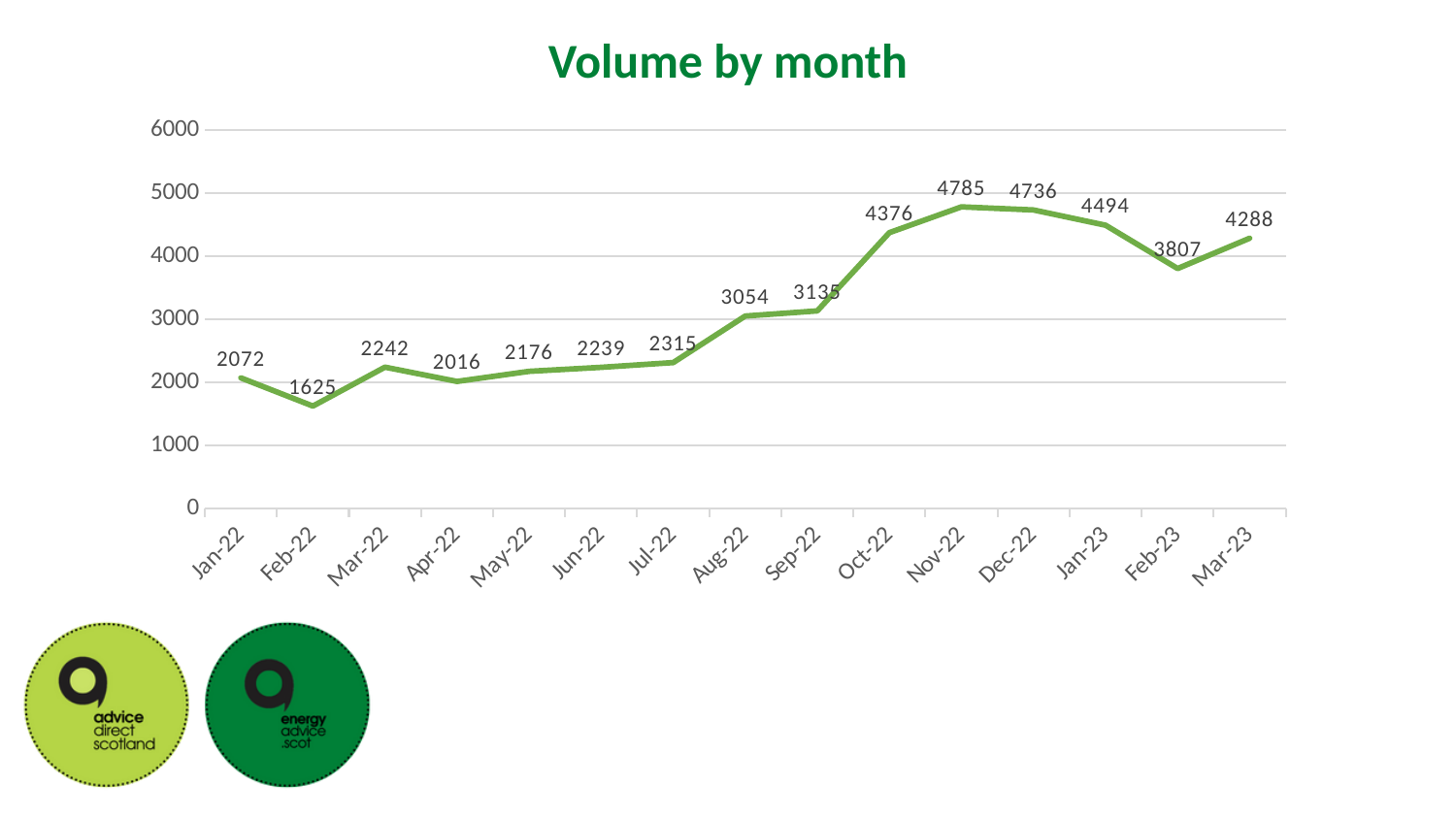
Is the volume for Feb-23 greater or less than 4000? less What is the volume for Aug-22? 3054 Which month has the lowest volume? Feb-22 Which month has the highest volume? Nov-22 How many months are plotted on the chart? 15 What is the difference in volume between Nov-22 and Feb-22? 3160 Which month has the larger volume, Jan-23 or Mar-23? Jan-23 What is the volume for Feb-22? 1625 What is the volume for Nov-22? 4785 What is the difference in volume between Oct-22 and Sep-22? 1241 What kind of chart is shown on the slide? Line chart What is the title of the chart? Volume by month